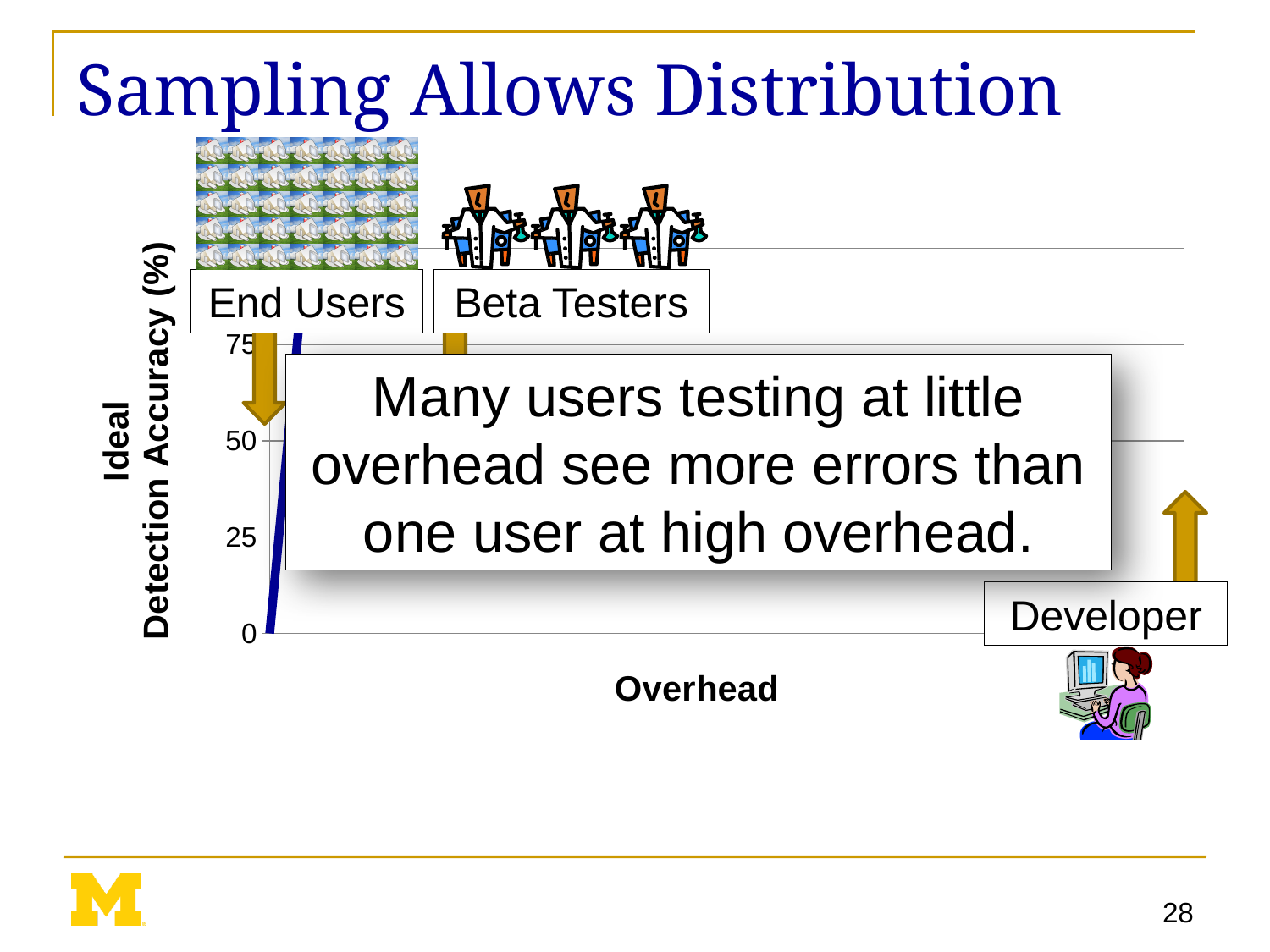
What is the title of the horizontal axis of the chart? Overhead What is the title of the vertical axis of the chart? Ideal Detection Accuracy (%) What kind of chart is shown on the slide? line chart Does the plotted line rise or fall as overhead increases along the x axis? rise